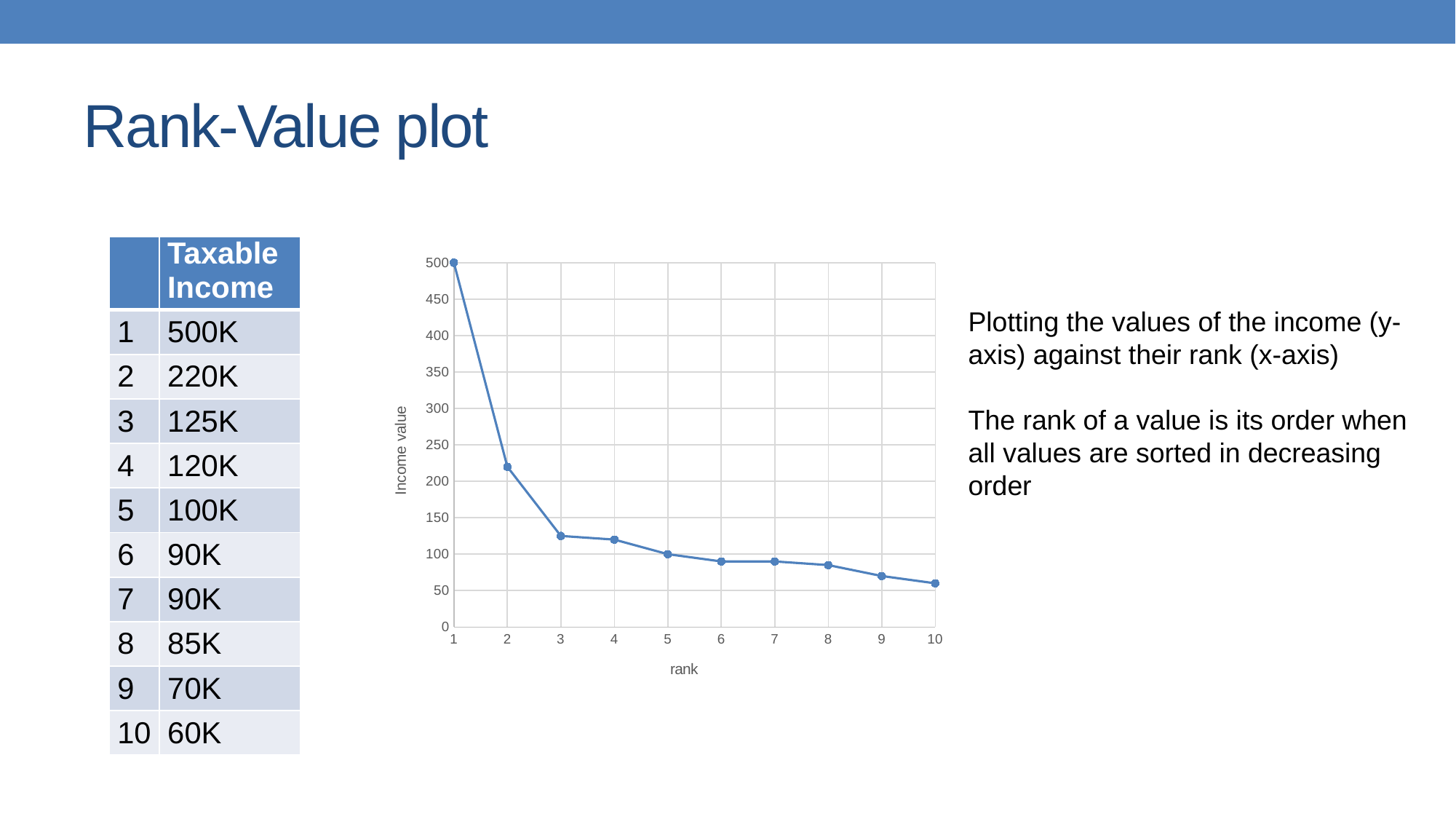
What is the difference between the income value at rank 1 and the income value at rank 5? 400 Do the income values rise or fall as rank increases along the x axis? fall Which rank has the lowest income value on the chart? 10 What is the label of the chart's y axis? Income value Is the income value at rank 2 greater or less than 200? greater Which has a larger income value, rank 2 or rank 3? rank 2 What is the income value plotted at rank 1? 500 What is the income value plotted at rank 5? 100 What kind of chart is shown on the slide? line chart Which rank has the highest income value on the chart? 1 Is the income value at rank 3 greater or less than 150? less How many data points are plotted on the chart? 10